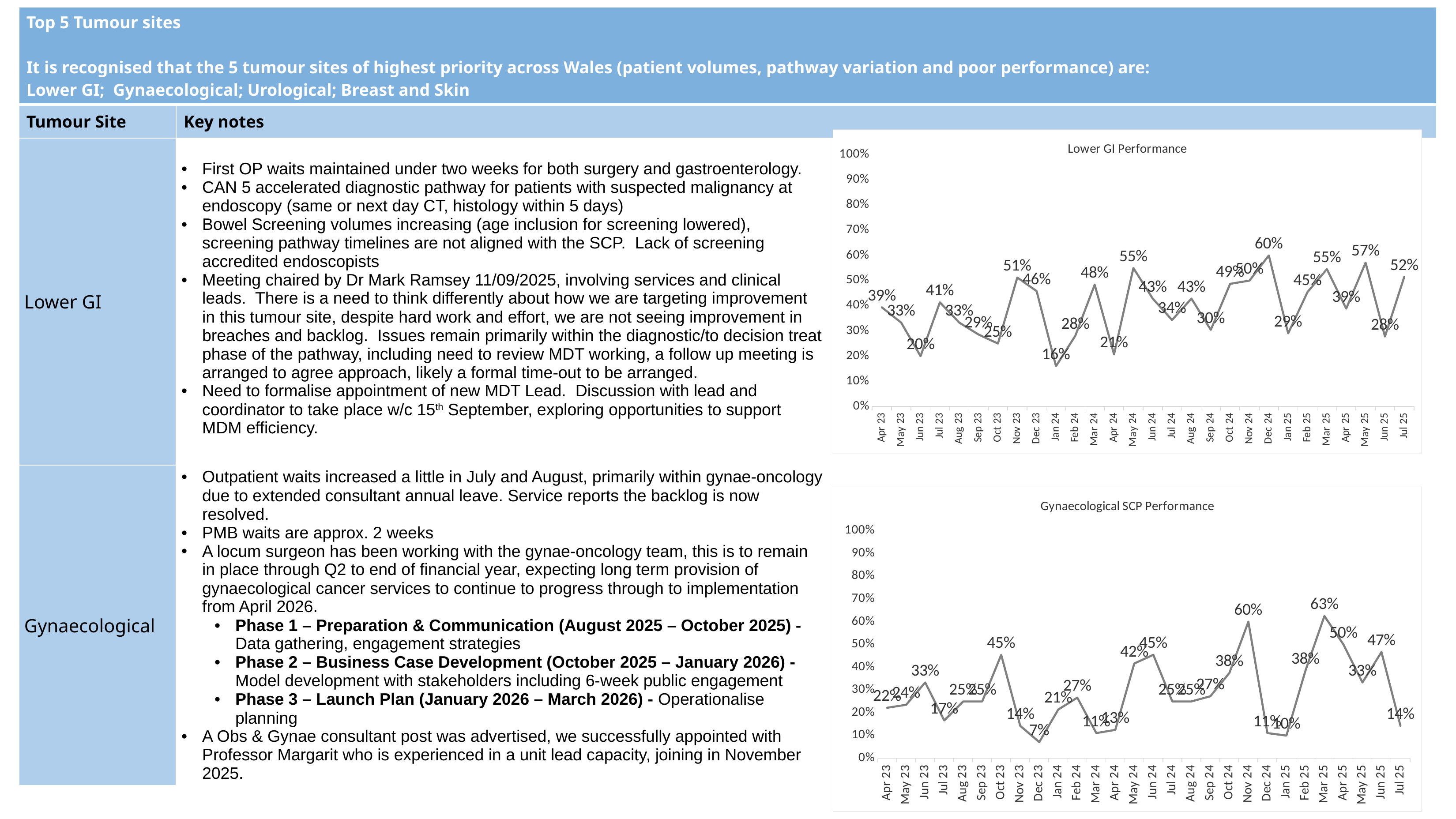
In the Lower GI Performance chart, what is the value for Jul 25? 52% What is the title of the lower chart on the slide? Gynaecological SCP Performance In the Gynaecological SCP Performance chart, what is the difference between the values for Mar 25 and Jul 25? 49 percentage points What type of chart is the Lower GI Performance chart? line chart In the Lower GI Performance chart, what is the difference between the values for Dec 24 and Jan 25? 31 percentage points In the Lower GI Performance chart, which month has the highest value? Dec 24 In the Gynaecological SCP Performance chart, which is larger, the value for Oct 23 or the value for Nov 23? Oct 23 In the Gynaecological SCP Performance chart, which month has the highest value? Mar 25 In the Lower GI Performance chart, how many monthly data points are plotted? 28 In the Gynaecological SCP Performance chart, what is the value for Nov 24? 60% In the Lower GI Performance chart, which month has the lowest value? Jan 24 In the Gynaecological SCP Performance chart, which month has the lowest value? Dec 23